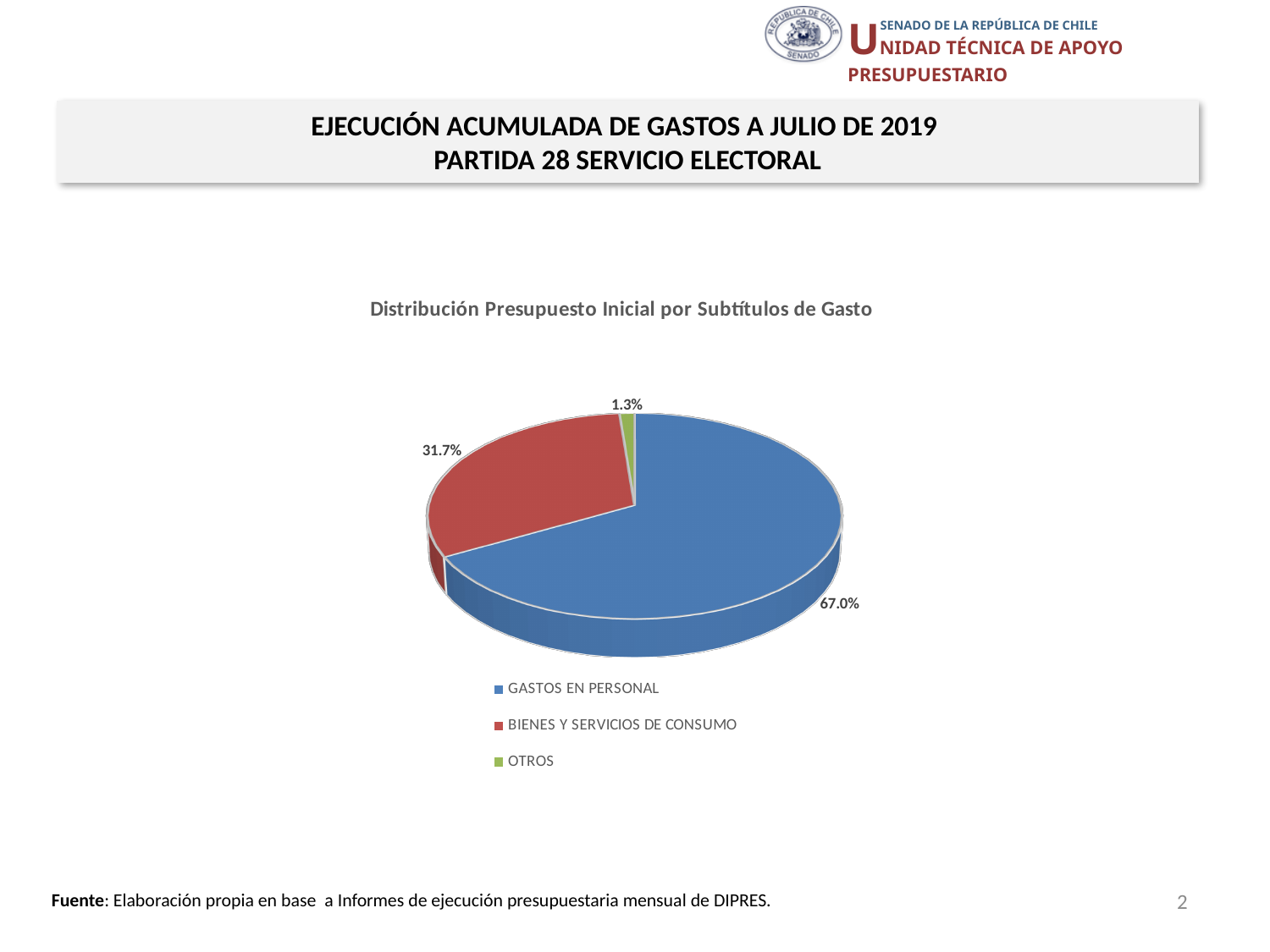
What share of the pie does GASTOS EN PERSONAL represent? 67.0% Which category has the largest slice of the pie? GASTOS EN PERSONAL What share of the pie does OTROS represent? 1.3% What type of chart is shown on the slide? Pie chart What share of the pie does BIENES Y SERVICIOS DE CONSUMO represent? 31.7% Which is larger, the share for BIENES Y SERVICIOS DE CONSUMO or the share for OTROS? BIENES Y SERVICIOS DE CONSUMO How many categories does the pie chart show? 3 What is the difference in percentage points between GASTOS EN PERSONAL and BIENES Y SERVICIOS DE CONSUMO? 35.3 percentage points How many entries does the legend list? 3 What colour is the slice for OTROS? Green Which category has the smallest slice of the pie? OTROS What is the title of the chart? Distribución Presupuesto Inicial por Subtítulos de Gasto